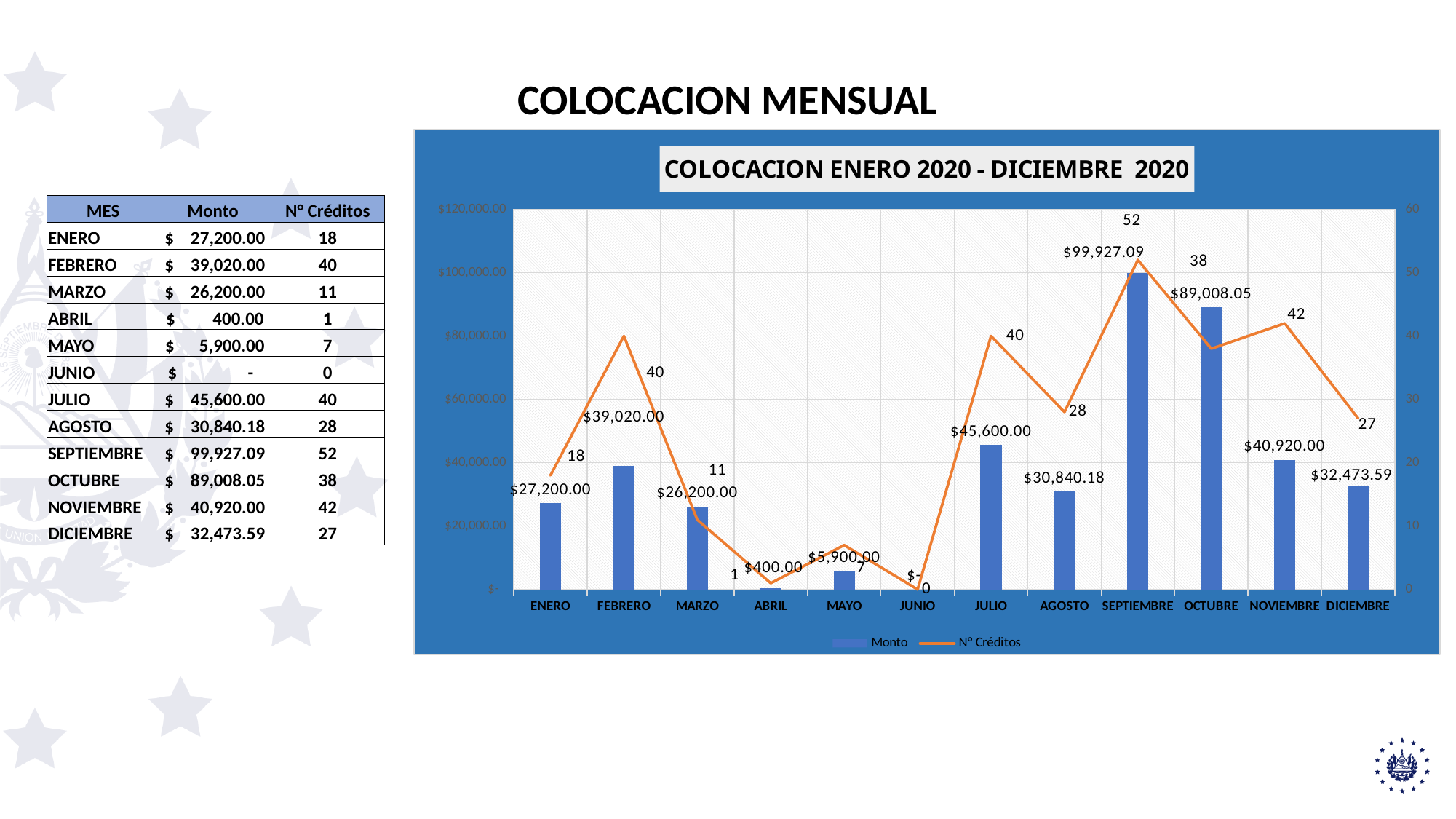
How many months are shown on the x axis of the chart? 12 Which month has the lowest N° Créditos? JUNIO What is the Monto value for SEPTIEMBRE? $99,927.09 What is the title of the chart? COLOCACION ENERO 2020 - DICIEMBRE 2020 What kind of chart is used to show the Monto series? bar chart Does the N° Créditos line rise or fall from SEPTIEMBRE to DICIEMBRE? fall How many series does the chart legend list? 2 Which month has a larger Monto, JULIO or AGOSTO? JULIO Which month has the highest Monto? SEPTIEMBRE Is the Monto for FEBRERO greater or less than $40,000.00? less What is the N° Créditos value for NOVIEMBRE? 42 What is the difference in Monto between OCTUBRE and NOVIEMBRE? $48,088.05